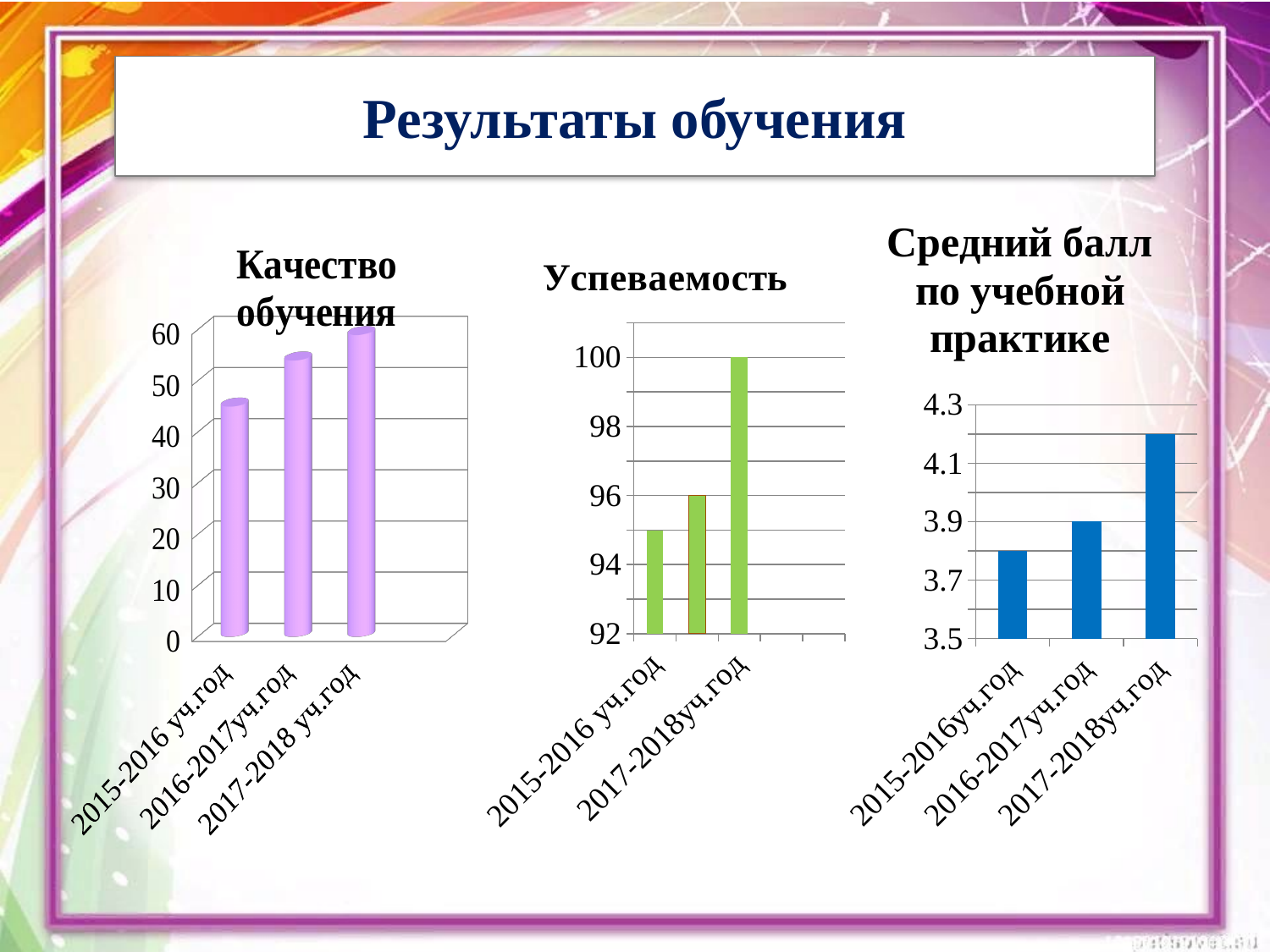
How many bars are plotted on the "Успеваемость" chart? 3 How many categories are shown on the "Качество обучения" chart? 3 On the "Средний балл по учебной практике" chart, which category has the highest value? 2017-2018уч.год On the "Успеваемость" chart, is the value for 2015-2016 уч.год greater or less than 96? less On the "Средний балл по учебной практике" chart, what is the value for 2016-2017уч.год? 3.9 On the "Качество обучения" chart, which category has the lowest value? 2015-2016 уч.год On the "Качество обучения" chart, is the value for 2015-2016 уч.год greater or less than 40? greater On the "Качество обучения" chart, which category has the highest value? 2017-2018 уч.год On the "Качество обучения" chart, do the values rise or fall from left to right? rise What colour are the bars on the "Средний балл по учебной практике" chart? blue What kind of chart is the "Качество обучения" chart? bar chart On the "Средний балл по учебной практике" chart, is the value for 2017-2018уч.год greater or less than 4.1? greater